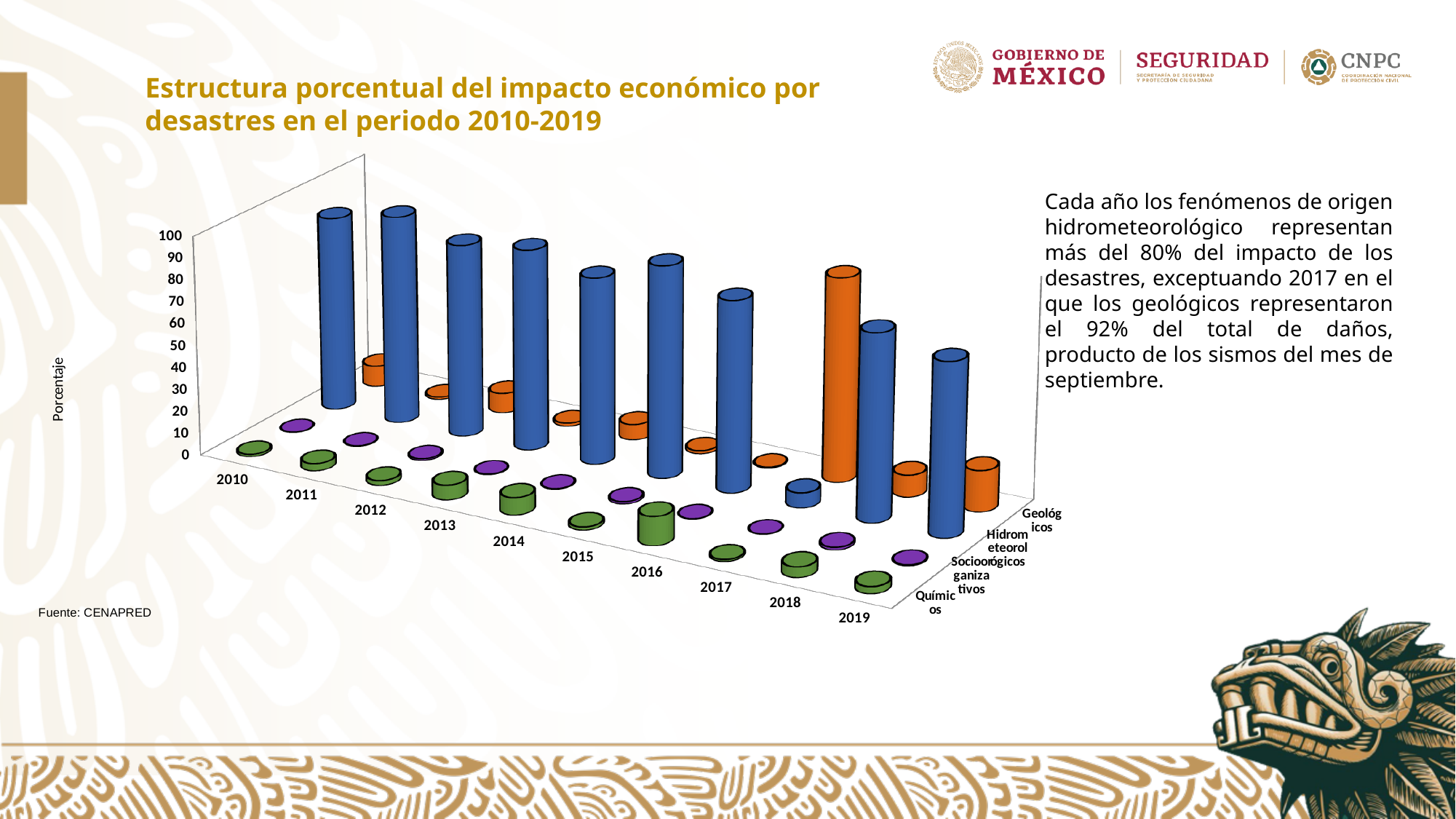
Is the Geológicos value for 2017 greater or less than 50? greater How many years are shown along the x axis of the chart? 10 What is the title of the chart on the slide? Estructura porcentual del impacto económico por desastres en el periodo 2010-2019 In which year is the Geológicos bar the highest? 2017 What kind of chart is shown on the slide? Bar chart In 2017, which is larger: the Geológicos value or the Hidrometeorológicos value? Geológicos Is the Hidrometeorológicos value for 2017 greater or less than 50? less How many disaster categories (series) does the chart plot? 4 In 2010, which is larger: the Hidrometeorológicos value or the Geológicos value? Hidrometeorológicos In which year is the Hidrometeorológicos bar the lowest? 2017 What is the label of the vertical axis of the chart? Porcentaje